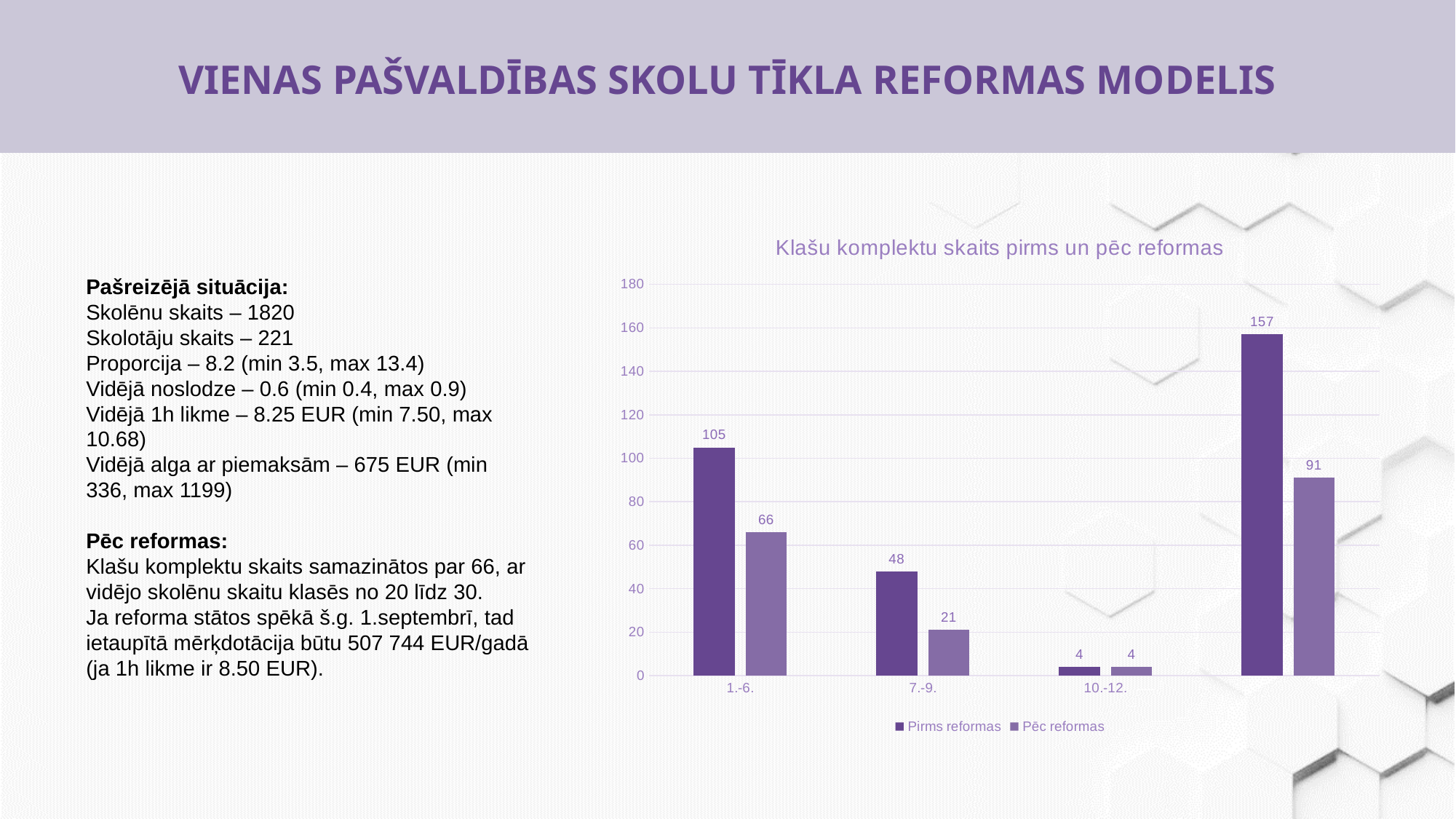
What is the Pirms reformas value for 7.-9.? 48 What is the Pēc reformas value for 1.-6.? 66 What is the difference between the Pirms reformas and Pēc reformas values for 1.-6.? 39 What is the title of the chart? Klašu komplektu skaits pirms un pēc reformas Among 1.-6., 7.-9. and 10.-12., which category has the lowest Pirms reformas value? 10.-12. How many series does the chart legend list? 2 What is the Pirms reformas value for 1.-6.? 105 What type of chart is shown on the slide? bar chart What is the difference between the Pirms reformas and Pēc reformas values for 7.-9.? 27 Is the Pēc reformas value for 1.-6. greater or less than 80? less What is the Pēc reformas value for 10.-12.? 4 Which is larger for 7.-9.: the Pirms reformas value or the Pēc reformas value? Pirms reformas